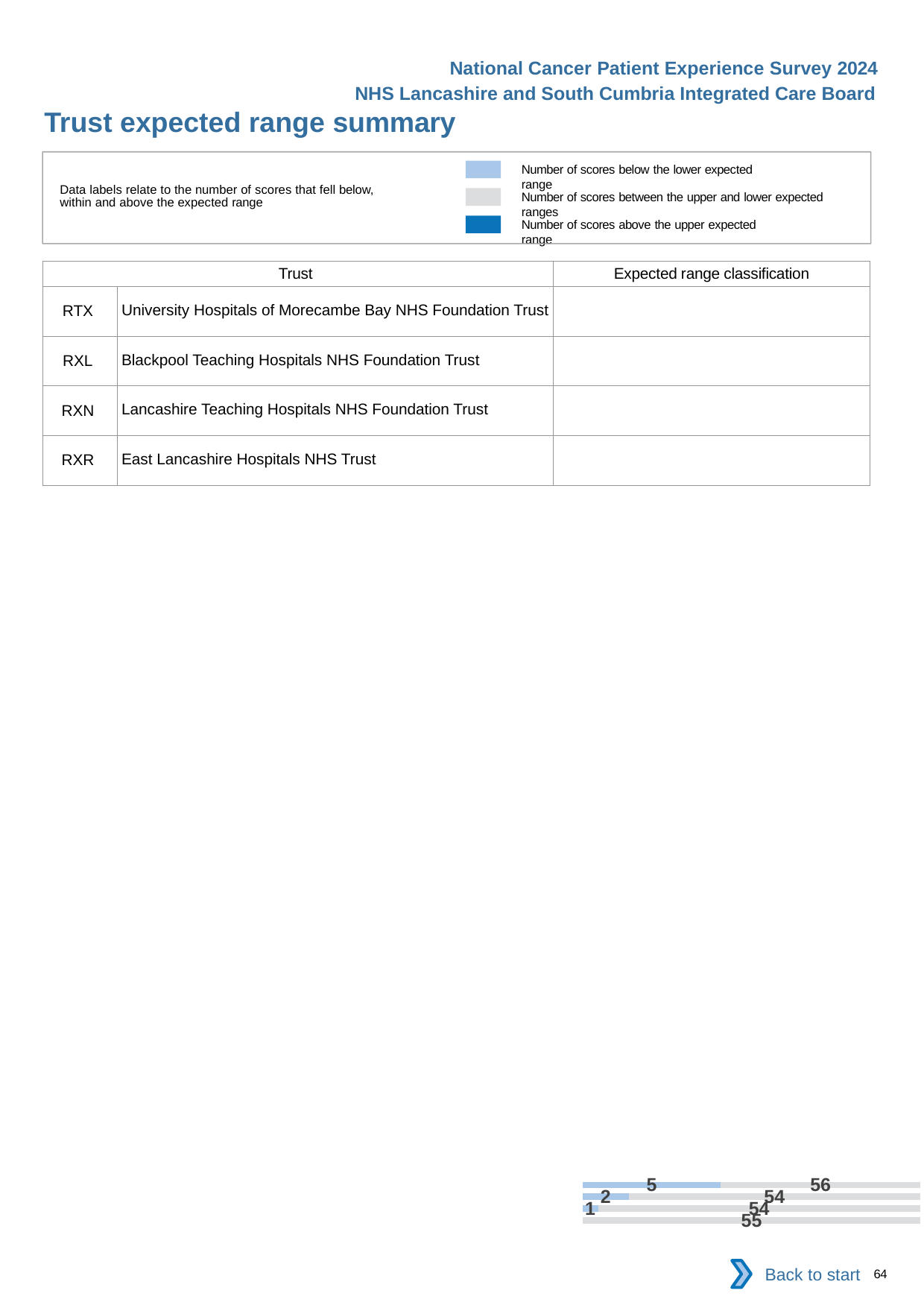
In the chart at the bottom right, what is the largest data label shown? 56 In the chart at the bottom right, what value is labelled on the light blue segment of the second bar from the top? 2 In the chart at the bottom right, what value is labelled on the grey segment of the top bar? 56 In the chart at the bottom right, what is the difference between the grey segment label on the top bar (56) and the light blue segment label on the top bar (5)? 51 According to the legend, what does the dark blue colour represent? Number of scores above the upper expected range How many series does the legend in the box at the top of the slide list? 3 In the chart at the bottom right, what is the smallest data label shown? 1 What kind of chart is shown at the bottom right of the slide? bar chart In the chart at the bottom right, what value is labelled on the light blue segment of the top bar? 5 According to the legend, what does the grey colour represent? Number of scores between the upper and lower expected ranges In the chart at the bottom right, which is larger: the light blue segment label on the top bar or the light blue segment label on the second bar? the top bar (5)